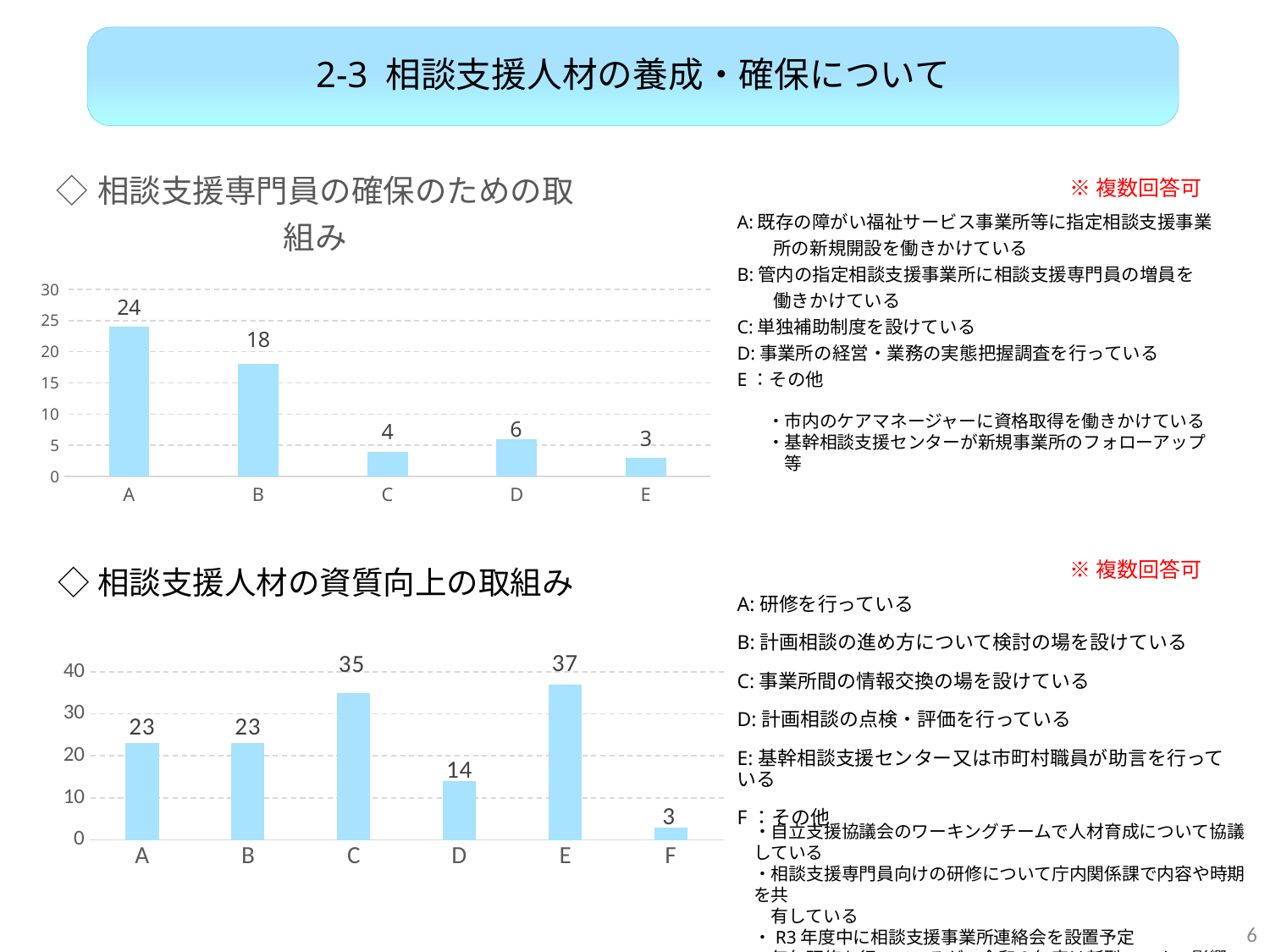
In the bottom chart, is the value for category C greater or less than 30? greater In the bottom chart, what is the value for category D? 14 In the top chart (相談支援専門員の確保のための取組み), what is the value for category A? 24 In the top chart, which is larger, the value for C or the value for D? D How many categories are shown in the top chart? 5 In the top chart, which category has the lowest value? E How many categories are shown in the bottom chart? 6 In the bottom chart, what is the difference between the values for E and C? 2 What type of chart is the bottom chart? Bar chart In the bottom chart, which category has the highest value? E In the top chart, what is the difference between the values for A and B? 6 In the bottom chart (相談支援人材の資質向上の取組み), what is the value for category E? 37